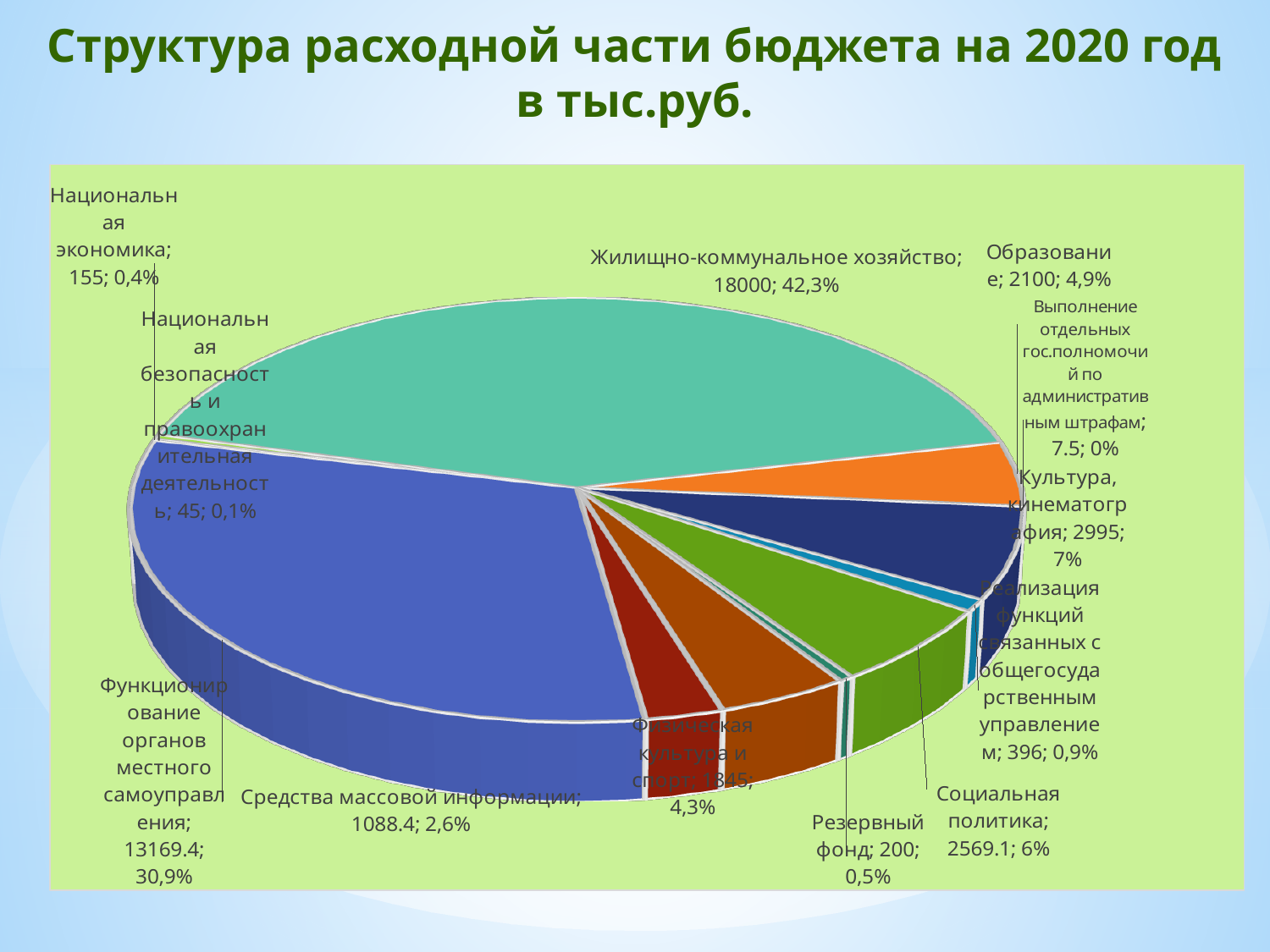
What is the title of the chart? Структура расходной части бюджета на 2020 год в тыс.руб. Which is larger, the value for Образование or the value for Физическая культура и спорт? Образование What is the value for Социальная политика? 2569.1 What share of the pie does Функционирование органов местного самоуправления take? 30,9% Which category has the smallest value? Выполнение отдельных гос.полномочий по административным штрафам What kind of chart is shown on the slide? pie chart What is the value for Резервный фонд? 200 What is the value for Жилищно-коммунальное хозяйство? 18000 What percentage is shown for Культура, кинематография? 7% How many categories does the pie chart show? 12 Which category has the largest slice of the pie? Жилищно-коммунальное хозяйство What is the difference between the values for Жилищно-коммунальное хозяйство and Функционирование органов местного самоуправления? 4830.6